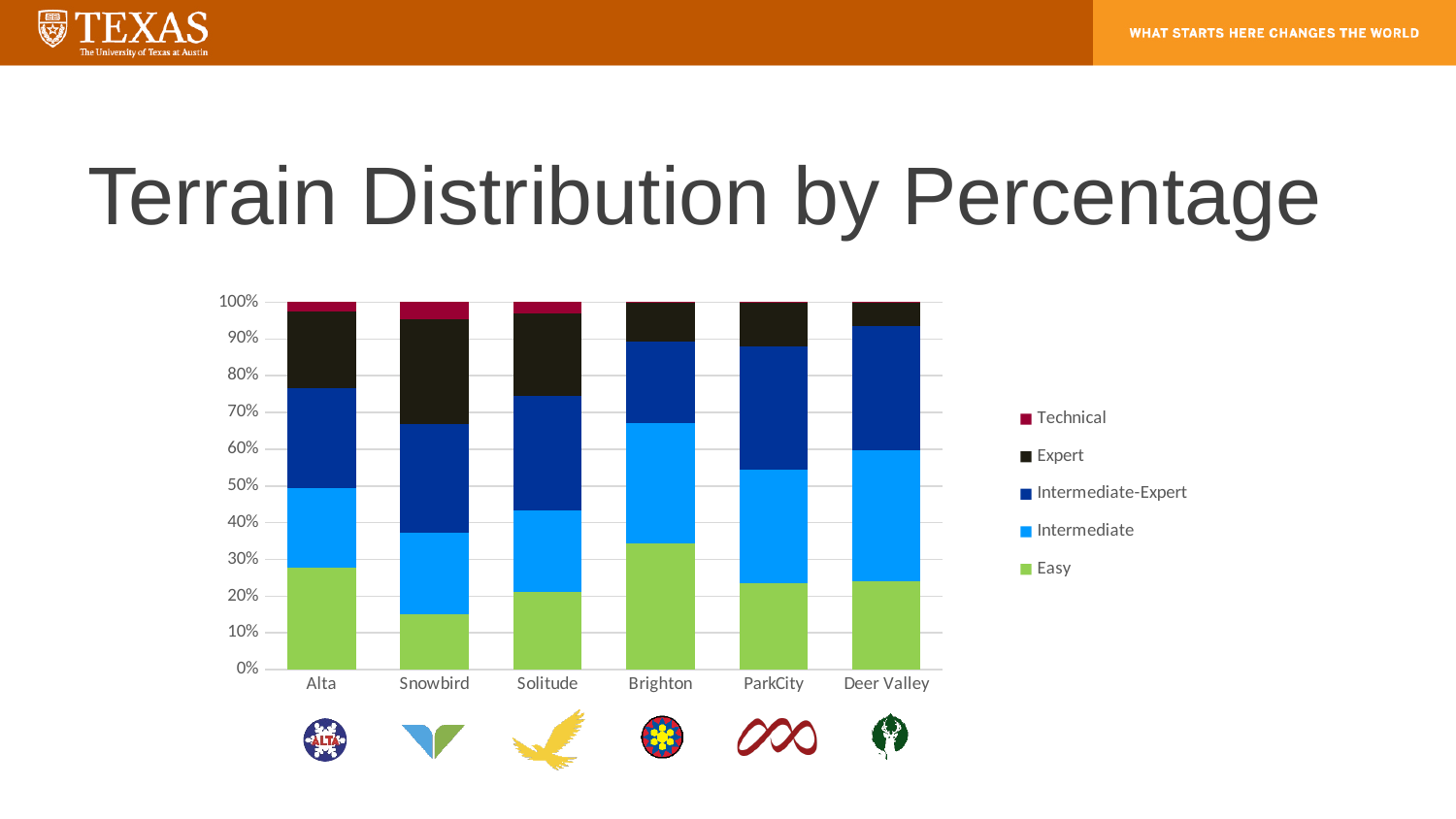
Which resort has the smallest Easy share? Snowbird Is the Easy share for Snowbird greater or less than 20%? less How many resorts (categories) are shown on the x axis? 6 What colour represents the Easy series? Green Is the Easy share for Alta greater or less than 20%? greater Is the Easy share for Brighton greater or less than 30%? greater How many resorts have a Technical segment in their bar? 3 What kind of chart is shown on the slide? Stacked bar chart Which series is listed first (at the top) in the legend? Technical Which resort has the largest Easy share? Brighton How many series does the legend list? 5 Which has the larger Easy share, Brighton or Alta? Brighton